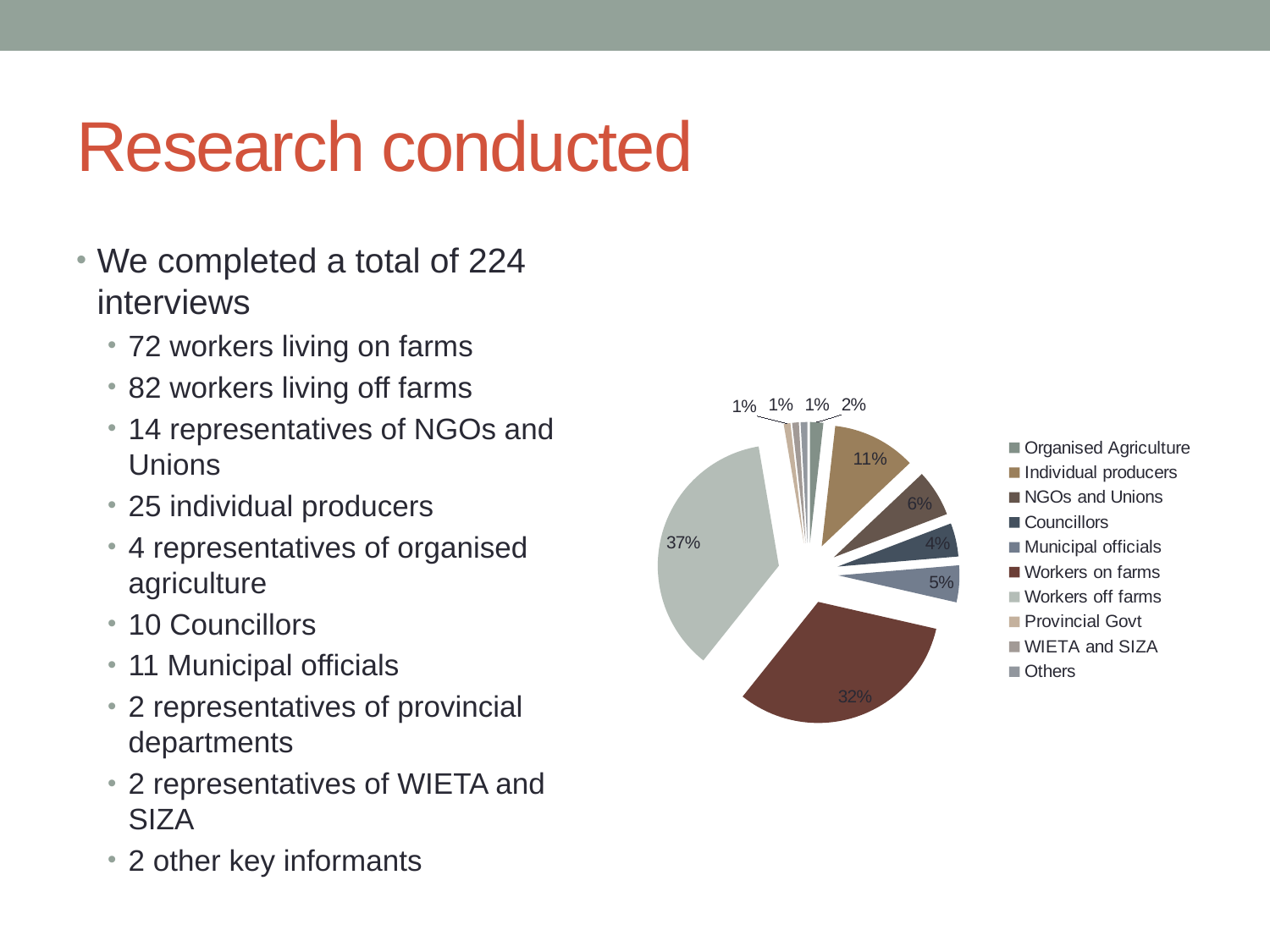
Which slice is larger, Individual producers or NGOs and Unions? Individual producers What percentage is shown for NGOs and Unions in the pie chart? 6% What share of the pie does Workers on farms represent? 32% What percentage is shown for Municipal officials in the pie chart? 5% What is the combined share of Workers on farms and Workers off farms? 69% What kind of chart is shown on the slide? pie chart What percentage is shown for Individual producers in the pie chart? 11% What is the difference in percentage points between Workers off farms and Workers on farms? 5 Which category has the largest slice of the pie chart? Workers off farms What share of the pie does Workers off farms represent? 37% How many categories does the pie chart's legend list? 10 What percentage is shown for Councillors in the pie chart? 4%